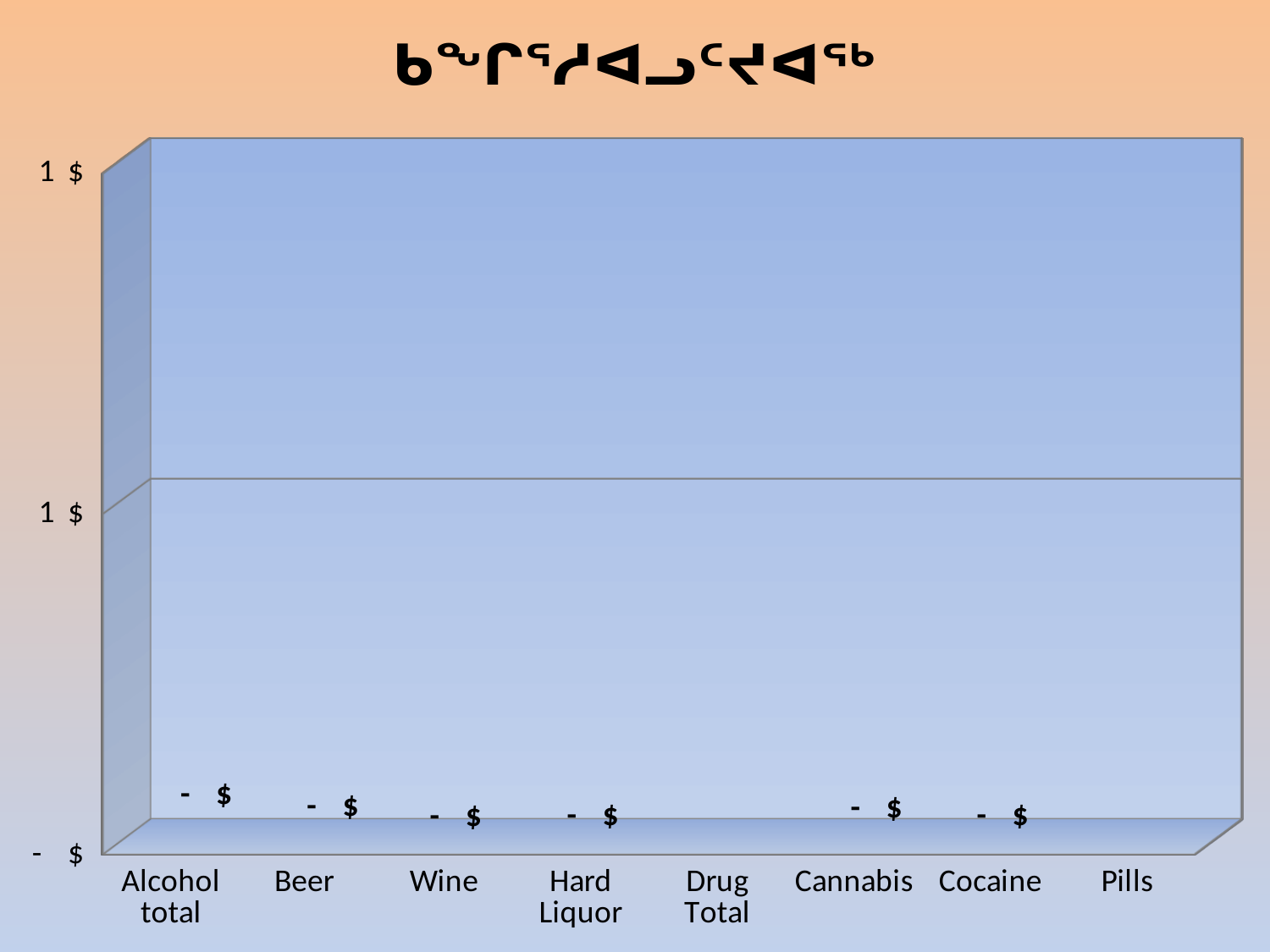
What data label is printed for Wine in the chart? - $ Is the value for Hard Liquor greater or less than 1 $? less What is the last category listed on the x axis of the chart? Pills Which category appears between Wine and Drug Total on the x axis? Hard Liquor Is the value for Alcohol total greater or less than 1 $? less What data label is printed for Cocaine in the chart? - $ What data label is printed for Beer in the chart? - $ How many categories are shown along the x axis of the chart? 8 What data label is printed for Cannabis in the chart? - $ What kind of chart is shown on the slide? bar chart What is the first category listed on the x axis of the chart? Alcohol total